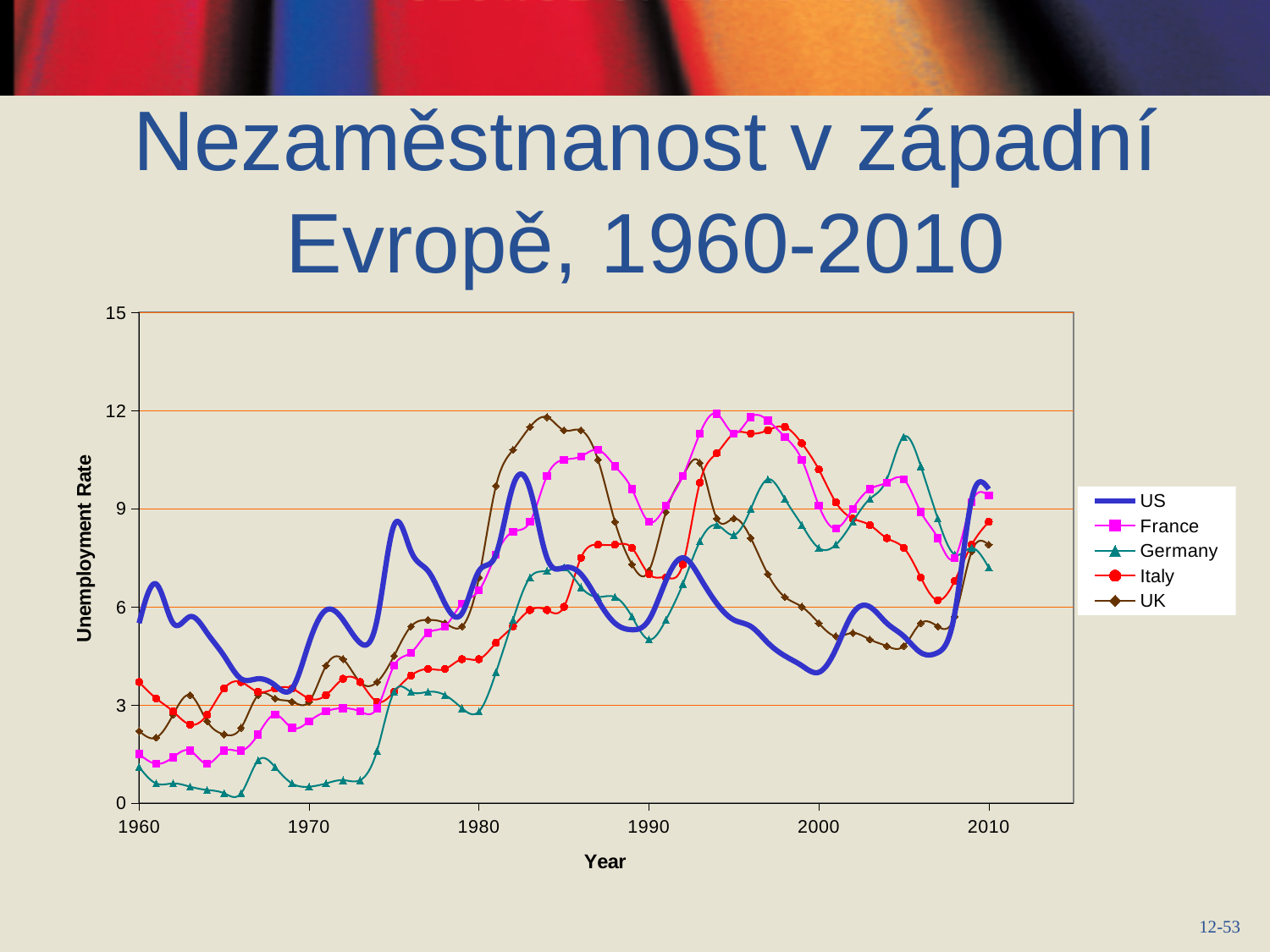
What is the title of the vertical axis? Unemployment Rate Is the value for Germany in 1960 greater or less than 3? less Is the value for Germany in 2005 greater or less than 9? greater Which series has the lowest value in 1970? Germany How many series does the legend list? 5 In 2000, which is larger, the value for France or the value for the US? France Is the value for the UK in 1984 greater or less than 9? greater What kind of chart is shown on the slide? line chart Which countries are listed in the chart's legend? US, France, Germany, Italy, UK Which series has the highest value in 1984? UK